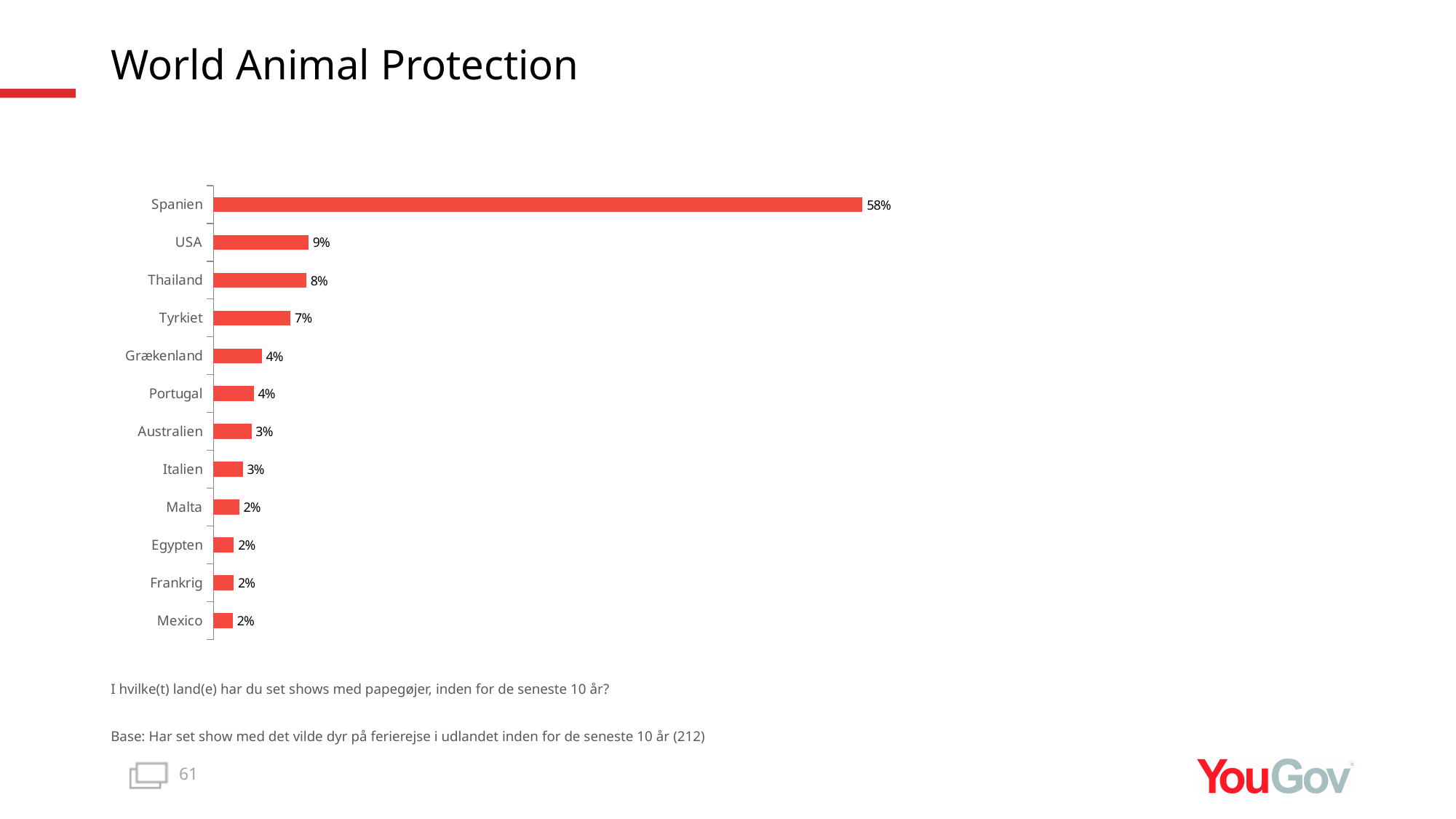
What is the difference between the values for USA and Grækenland? 5% What is the difference between the values for Spanien and USA? 49% What is the title of the slide? World Animal Protection Which is larger, the value for Australien or the value for Thailand? Thailand Which country has the highest value? Spanien What is the value for Tyrkiet? 7% What is the value for Spanien? 58% Which is larger, the value for USA or the value for Tyrkiet? USA What is the value for Thailand? 8% What is the value for Malta? 2% What kind of chart is shown on the slide? Bar chart How many countries are shown in the chart? 12